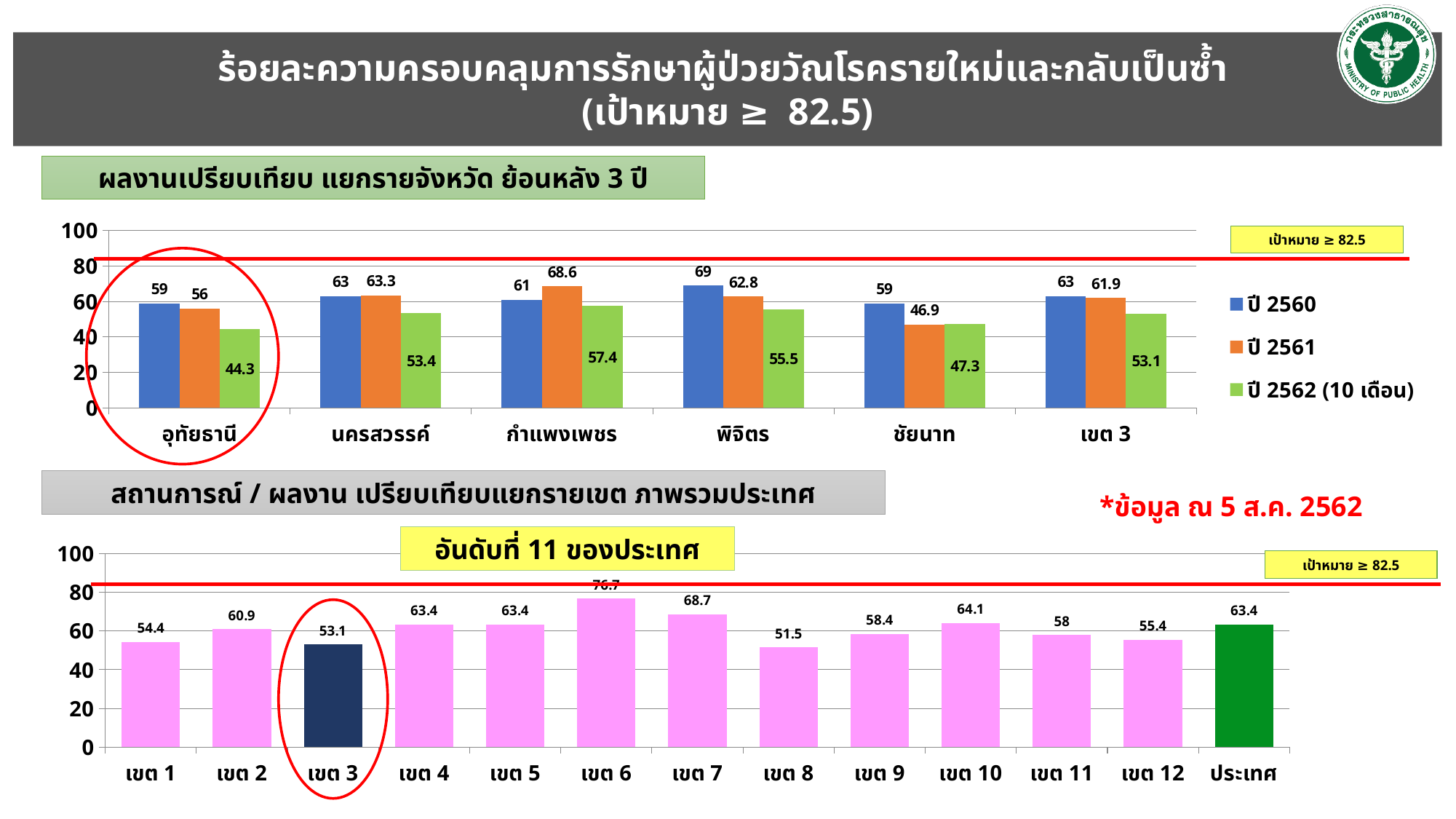
In the bottom chart, which is larger, the value for เขต 3 or the value for ประเทศ? ประเทศ In the bottom chart, which category has the lowest value? เขต 8 In the top chart, what is the value for กำแพงเพชร in ปี 2561? 68.6 In the bottom chart, what is the value for เขต 6? 76.7 How many series does the legend of the top chart list? 3 In the top chart, what is the value for อุทัยธานี in ปี 2562 (10 เดือน)? 44.3 In the top chart, is the ปี 2560 value for พิจิตร greater or less than 80? less In the top chart, what is the difference between the ปี 2561 and ปี 2562 (10 เดือน) values for นครสวรรค์? 9.9 What kind of chart is the bottom chart? bar chart In the top chart, which province has the highest value for ปี 2560? พิจิตร In the top chart, which category has the lowest value for ปี 2561? ชัยนาท How many bars are shown in the bottom chart? 13